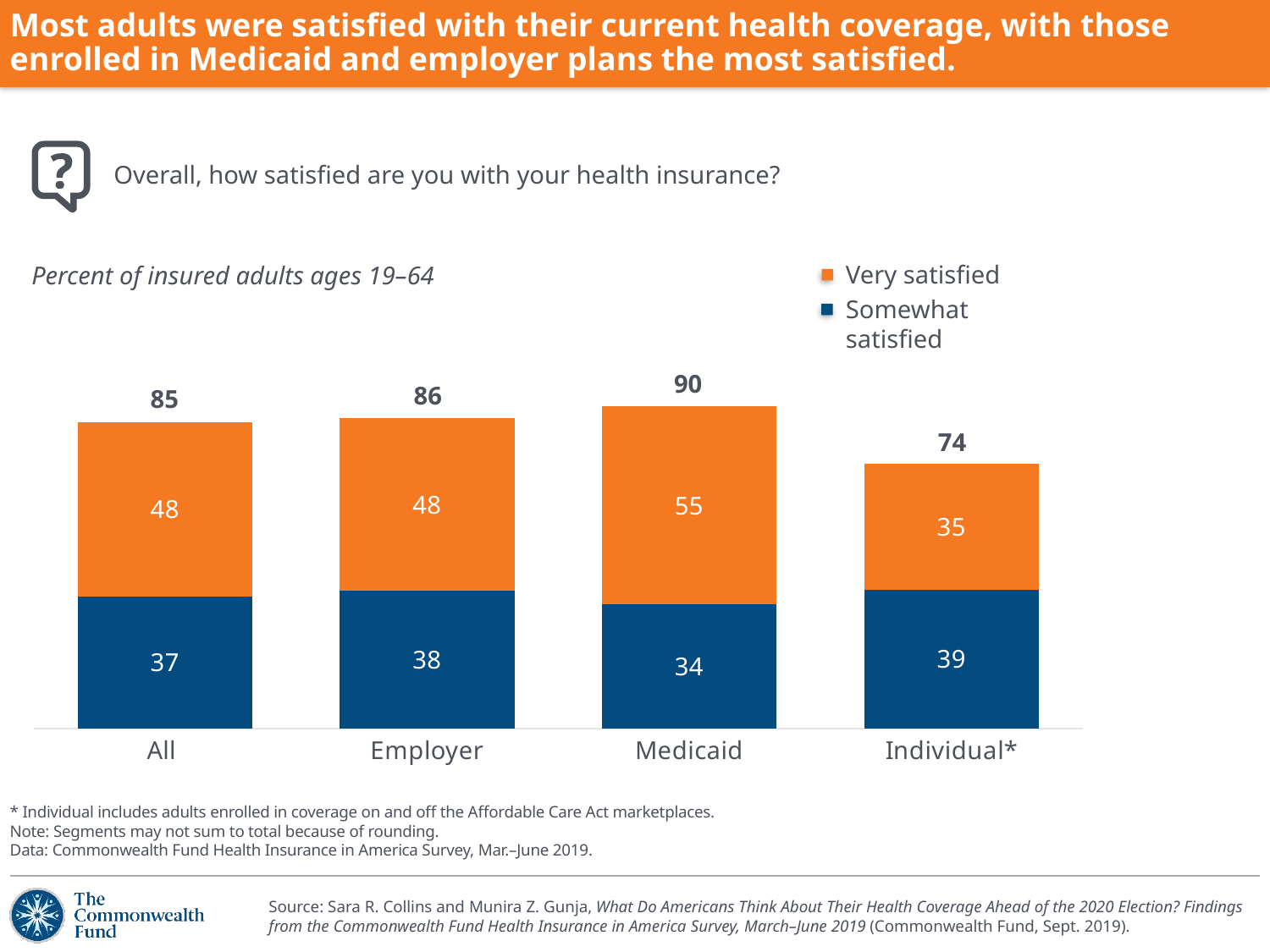
What is the total printed above the Employer bar? 86 How many series does the legend list? 2 Which category has the lowest total shown above its bar? Individual* How many categories are shown on the x axis? 4 What is the 'Very satisfied' value for Medicaid? 55 What is the 'Very satisfied' value for All? 48 Which is larger, the 'Somewhat satisfied' value for Employer or for Medicaid? Employer Which series is shown in orange? Very satisfied What is the 'Somewhat satisfied' value for Individual*? 39 What kind of chart is shown on the slide? Stacked bar chart Which category has the highest total shown above its bar? Medicaid What is the difference between the 'Very satisfied' values for Medicaid and Individual*? 20